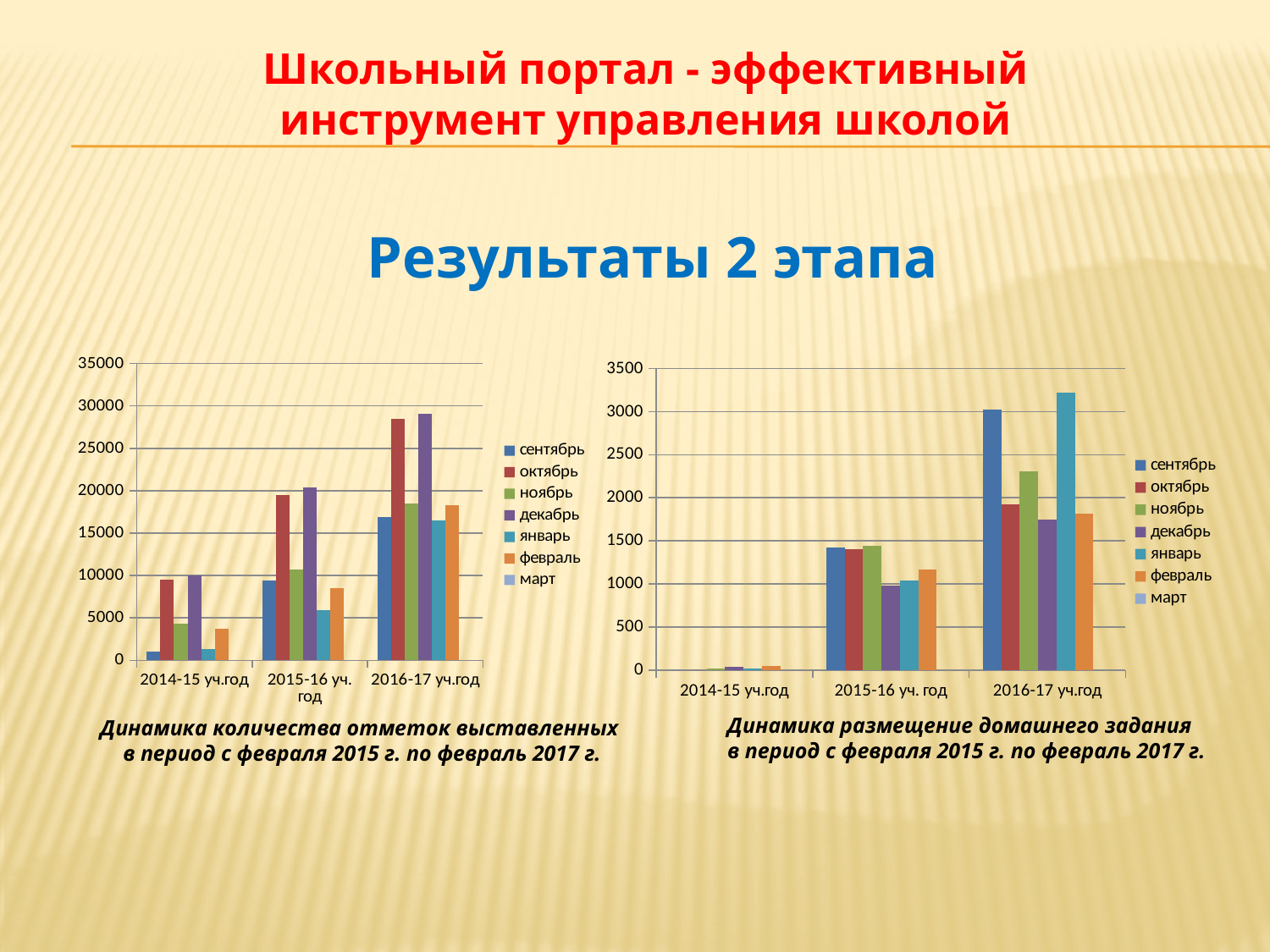
In the left chart, 'Динамика количества отметок выставленных', which is larger for 2016-17 уч.год: октябрь or ноябрь? октябрь In the left chart, 'Динамика количества отметок выставленных', is the value for ноябрь in 2014-15 уч.год greater or less than 5000? less What is the last month listed in the legend of the left chart, 'Динамика количества отметок выставленных'? март In the left chart, 'Динамика количества отметок выставленных', is the value for февраль in 2015-16 уч. год greater or less than 10000? less In the right chart, 'Динамика размещение домашнего задания', does the value for сентябрь rise or fall from 2015-16 уч. год to 2016-17 уч.год? rise In the right chart, 'Динамика размещение домашнего задания', is the value for январь in 2016-17 уч.год greater or less than 3000? greater How many series does the legend of the right chart, 'Динамика размещение домашнего задания', list? 7 What kind of chart is the left chart, 'Динамика количества отметок выставленных'? bar chart In the right chart, 'Динамика размещение домашнего задания', which month has the highest value in 2016-17 уч.год? январь How many school-year categories are shown on the x axis of the left chart, 'Динамика количества отметок выставленных'? 3